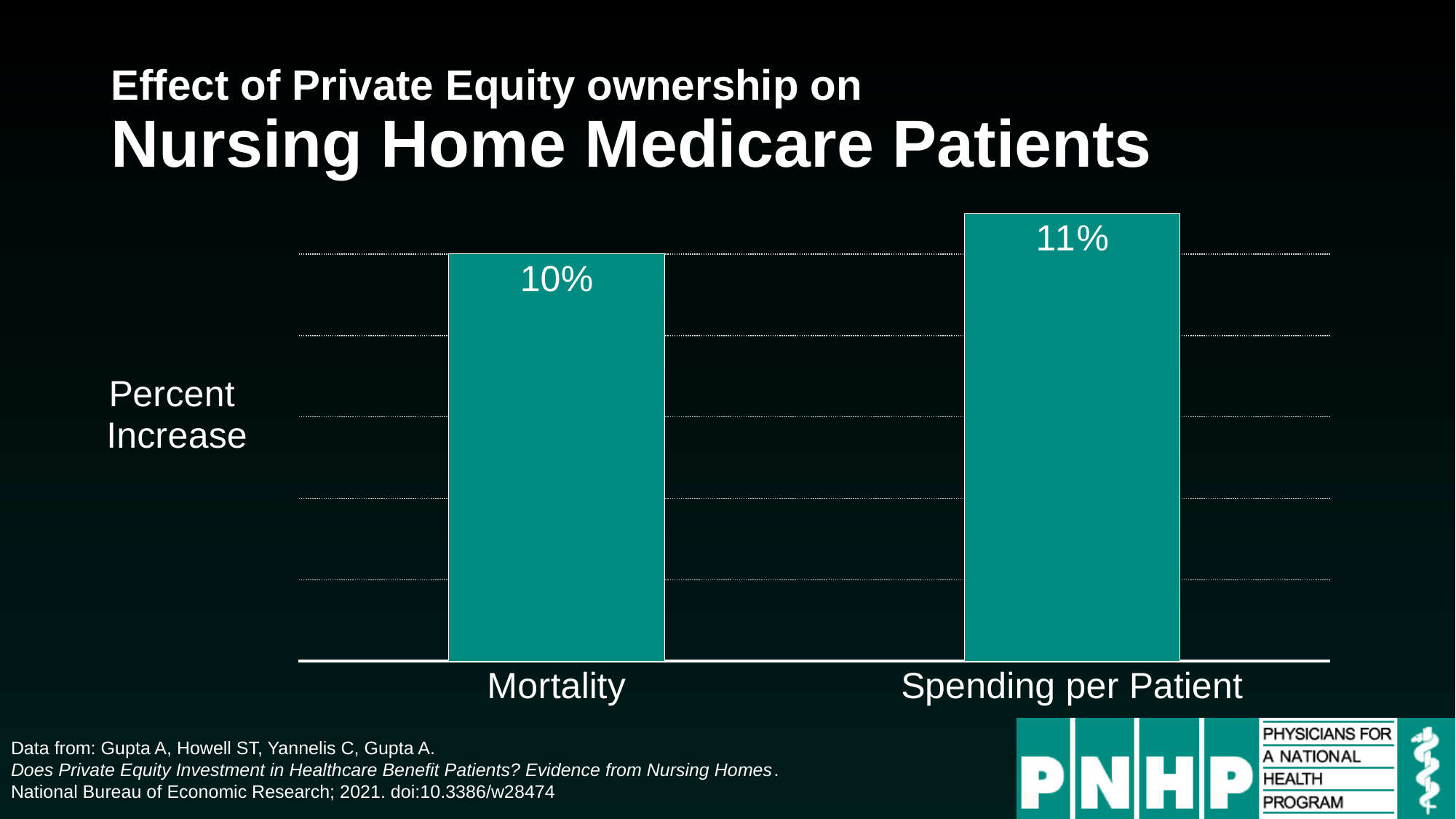
What is the label on the vertical axis of the chart? Percent Increase How many categories are plotted on the chart? 2 Which category has the lower percent increase? Mortality What colour are the bars in the chart? teal Which category has the higher percent increase? Spending per Patient What is the percent increase in Spending per Patient shown on the chart? 11% What is the difference between the percent increase for Spending per Patient and for Mortality? 1% What kind of chart is shown on the slide? bar chart What is the percent increase in Mortality shown on the chart? 10% Is the percent increase for Mortality larger or smaller than that for Spending per Patient? smaller